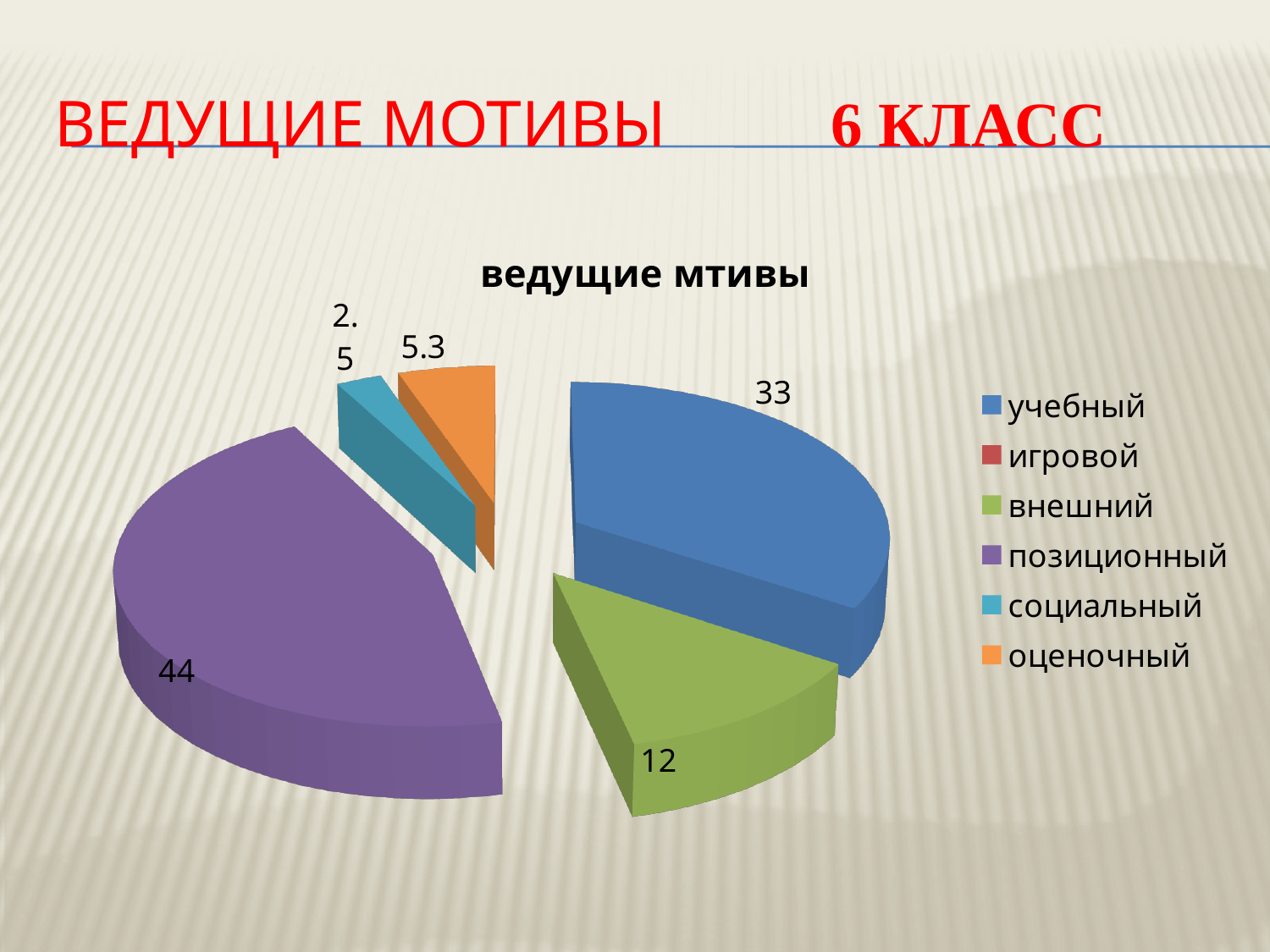
Which is larger, the value for учебный or the value for внешний? учебный What is the value for оценочный? 5.3 How many categories does the legend list? 6 Which category has the largest slice? позиционный Which labelled slice has the smallest value? социальный What is the difference between the values for позиционный and учебный? 11 What is the value for социальный? 2.5 What type of chart is shown on the slide? pie chart What is the value for учебный? 33 What is the value for позиционный? 44 What is the title of the chart? ведущие мтивы What is the value for внешний? 12